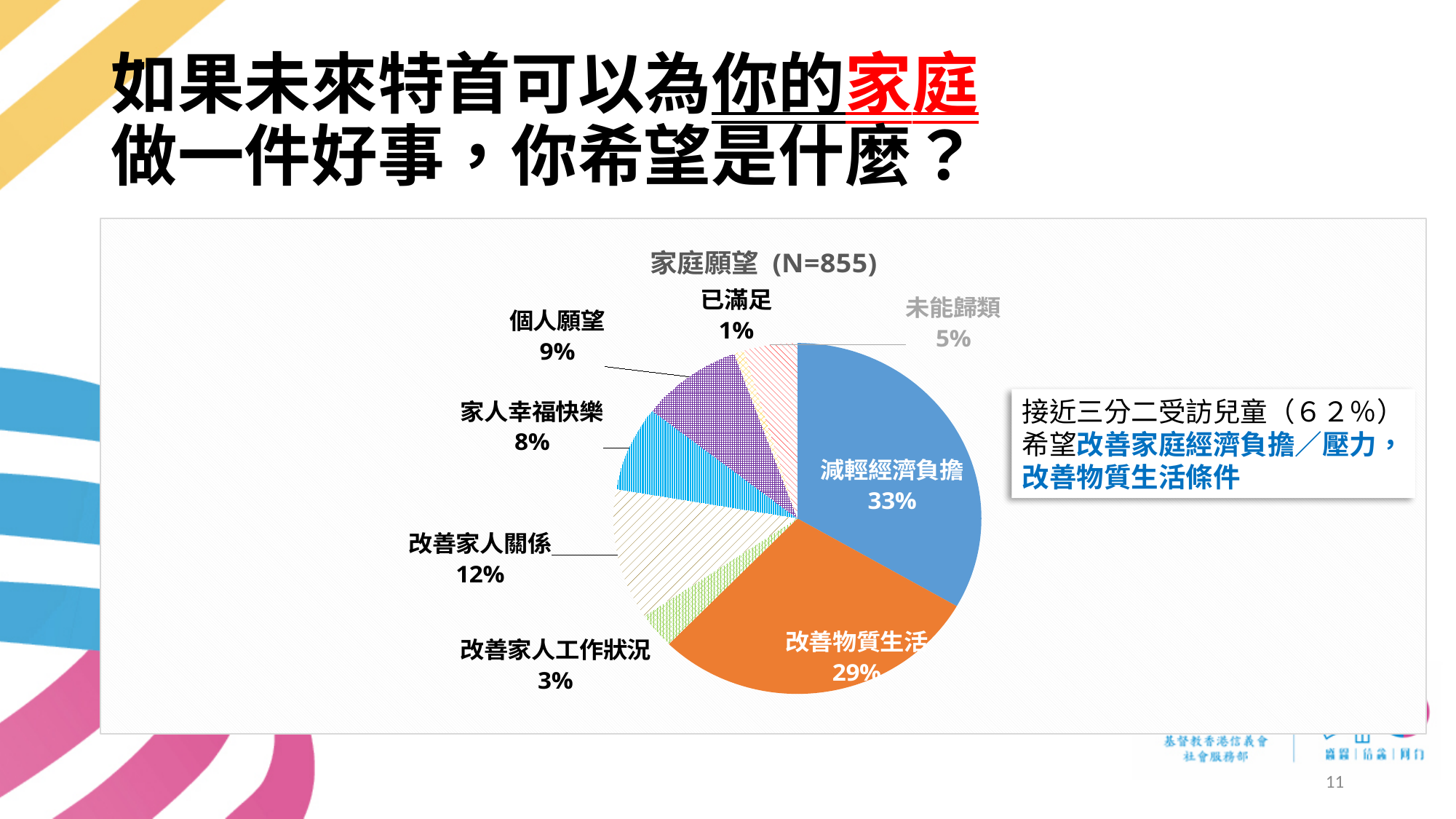
Which is larger, the share for 個人願望 or the share for 家人幸福快樂? 個人願望 What is the title of the chart? 家庭願望 (N=855) How many categories are shown in the pie chart? 8 What type of chart is shown on the slide? Pie chart What percentage of the pie is 減輕經濟負擔? 33% What percentage of the pie is 改善物質生活? 29% Which category has the largest share of the pie? 減輕經濟負擔 What is the difference in percentage points between 減輕經濟負擔 and 改善物質生活? 4 What percentage of the pie is 改善家人關係? 12% What percentage of the pie is 改善家人工作狀況? 3% What is the combined share of 減輕經濟負擔 and 改善物質生活? 62% Which category has the smallest share of the pie? 已滿足